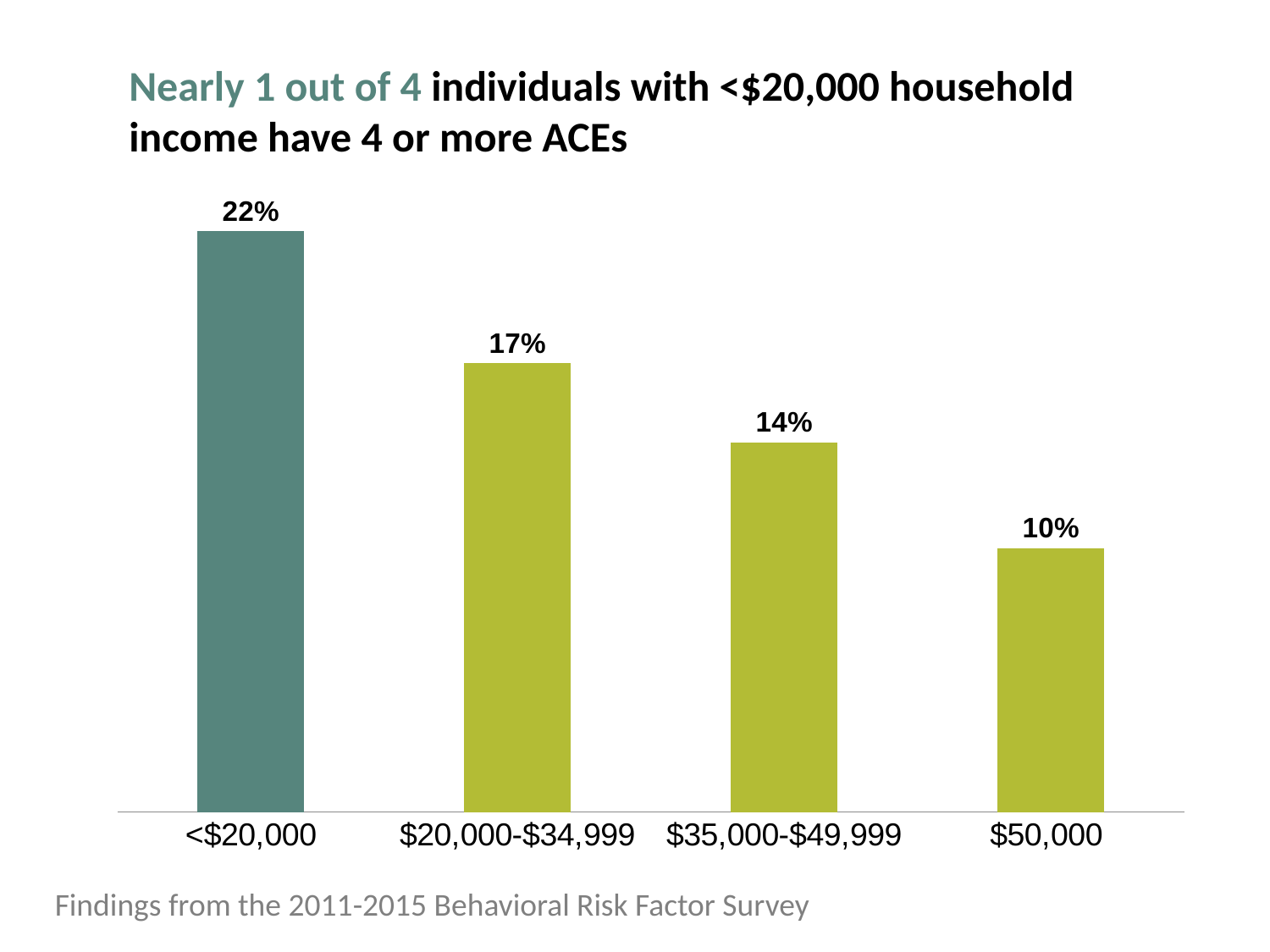
What is the value shown for the $35,000-$49,999 income group? 14% What is the value shown for the $50,000 income group? 10% What kind of chart is shown on the slide? Bar chart What percentage of individuals with household income <$20,000 have 4 or more ACEs? 22% How many income categories are shown in the chart? 4 What is the difference between the values for the $20,000-$34,999 and $35,000-$49,999 income groups? 3% Which is larger, the value for $20,000-$34,999 or the value for $35,000-$49,999? $20,000-$34,999 Do the values rise or fall as household income increases along the x axis? Fall What is the difference between the values for the <$20,000 and $50,000 income groups? 12% Which income group has the highest percentage with 4 or more ACEs? <$20,000 Which income group has the lowest percentage with 4 or more ACEs? $50,000 What is the value shown for the $20,000-$34,999 income group? 17%